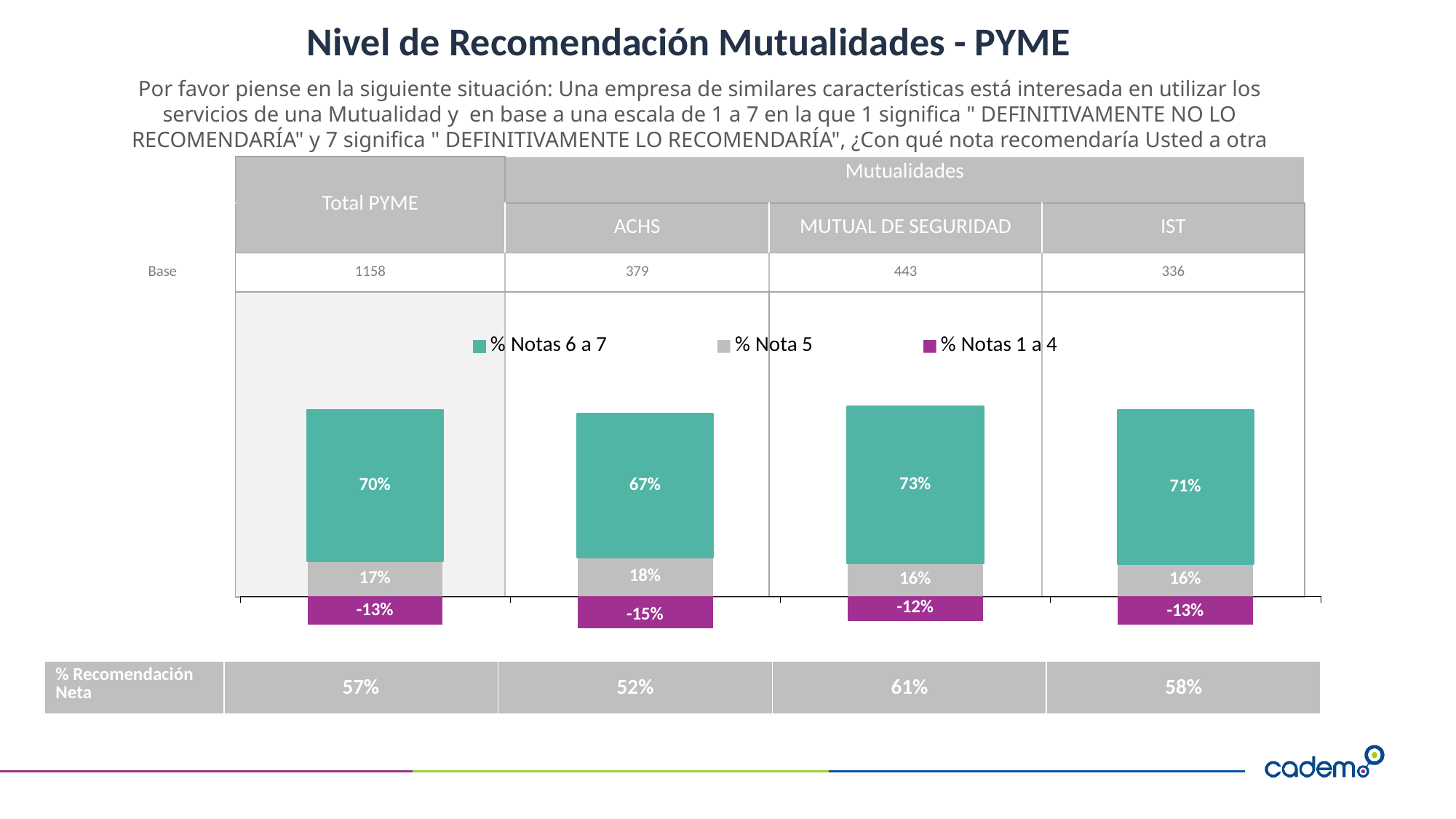
What is the value of % Notas 6 a 7 for MUTUAL DE SEGURIDAD? 73% Which colour represents the % Notas 1 a 4 series in the chart? Purple What is the value of % Notas 1 a 4 for IST? -13% What kind of chart is shown on the slide? Stacked bar chart How many series does the legend list? 3 What is the difference between the % Notas 6 a 7 values for MUTUAL DE SEGURIDAD and ACHS? 6% Which is larger, the % Nota 5 value for Total PYME or for ACHS? ACHS How many categories are shown on the x axis of the chart? 4 Which category has the lowest value for % Notas 6 a 7? ACHS What is the % Recomendación Neta value shown for IST? 58% What is the value of % Nota 5 for ACHS? 18% Which category has the highest value for % Notas 6 a 7? MUTUAL DE SEGURIDAD